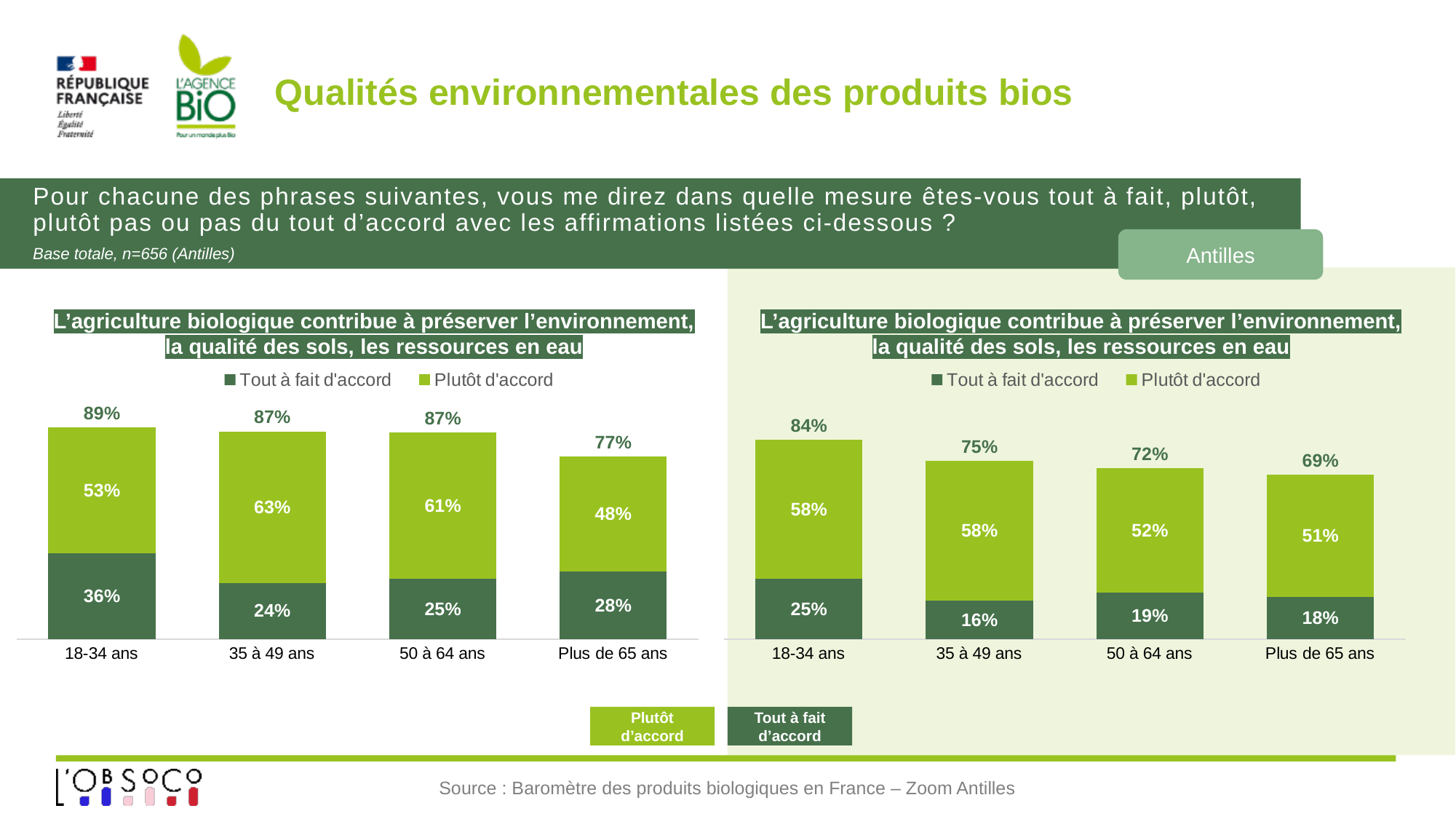
In the right chart, which age group has the lowest "Tout à fait d'accord" value? 35 à 49 ans How many series does the legend of the right chart list? 2 In the left chart, what is the value of "Tout à fait d'accord" for 18-34 ans? 36% In the left chart, what is the total shown above the bar for 35 à 49 ans? 87% In the left chart, what is the total shown above the bar for Plus de 65 ans? 77% In the right chart, which is larger: the "Tout à fait d'accord" value for 18-34 ans or for Plus de 65 ans? 18-34 ans In the right chart, which age group has the highest total? 18-34 ans In the right chart, what is the value of "Plutôt d'accord" for 50 à 64 ans? 52% In the right chart, do the totals above the bars rise or fall from 18-34 ans to Plus de 65 ans? Fall What type of chart is the left chart? Stacked bar chart How many age groups are shown in the left chart? 4 In the left chart, what is the difference between the "Plutôt d'accord" values for 35 à 49 ans and Plus de 65 ans? 15%